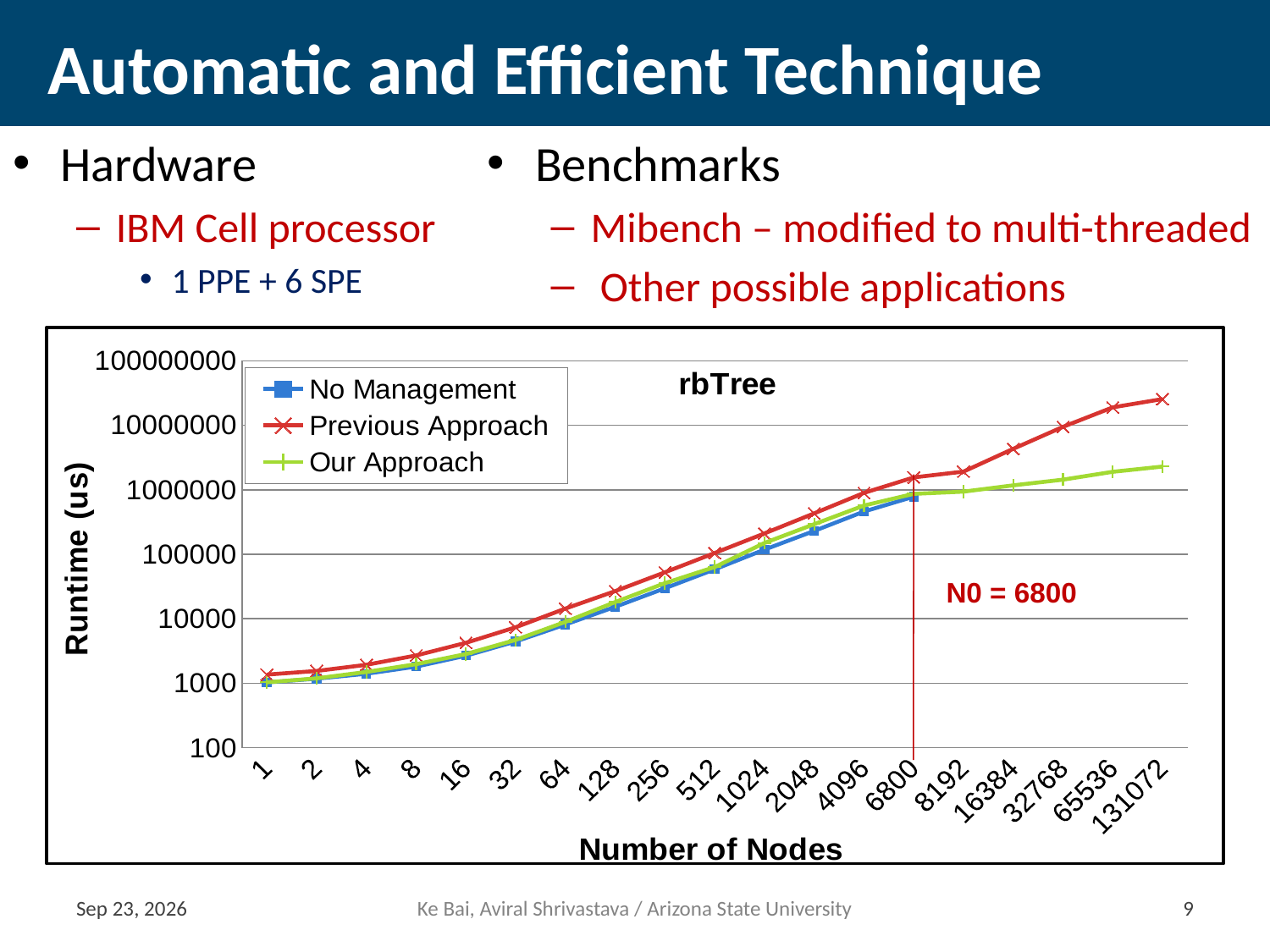
What is the title of the chart? rbTree At 131072 nodes, which is larger: the runtime for Previous Approach or for Our Approach? Previous Approach What kind of chart is shown on the slide? line chart Which series has the highest runtime at 131072 nodes? Previous Approach Is the runtime for Previous Approach at 131072 nodes greater or less than 10000000? greater Is the runtime for Previous Approach at 64 nodes greater or less than 10000? greater Is the runtime for Our Approach at 131072 nodes greater or less than 10000000? less How many node-count categories are shown on the x axis? 19 What is the label of the y axis? Runtime (us) How many series does the chart legend list? 3 Does runtime rise or fall as the number of nodes increases? rise Which series has the highest runtime at 512 nodes? Previous Approach